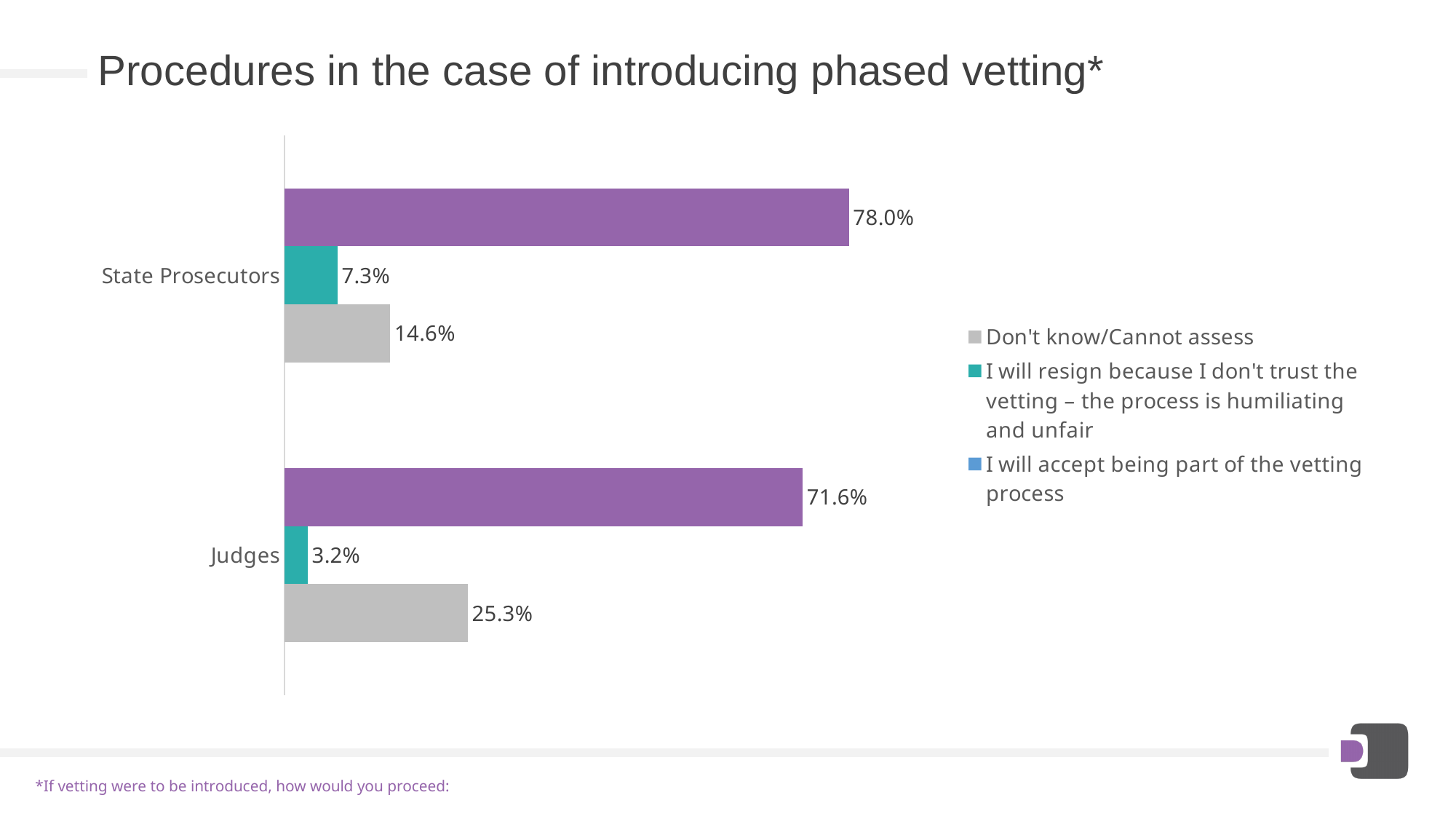
How many series does the legend list? 3 What percentage of Judges say they will resign because they don't trust the vetting? 3.2% What is the value for 'Don't know/Cannot assess' among Judges? 25.3% What percentage of State Prosecutors say they will accept being part of the vetting process? 78.0% Which category has the higher value for 'Don't know/Cannot assess', State Prosecutors or Judges? Judges What kind of chart is shown on the slide? bar chart What is the title of the chart on the slide? Procedures in the case of introducing phased vetting* How many categories are shown on the chart? 2 Which response has the lowest value among Judges? I will resign because I don't trust the vetting – the process is humiliating and unfair What is the difference between the 'I will accept being part of the vetting process' values for State Prosecutors and Judges? 6.4% What is the value for 'Don't know/Cannot assess' among State Prosecutors? 14.6% What percentage of State Prosecutors say they will resign because they don't trust the vetting? 7.3%